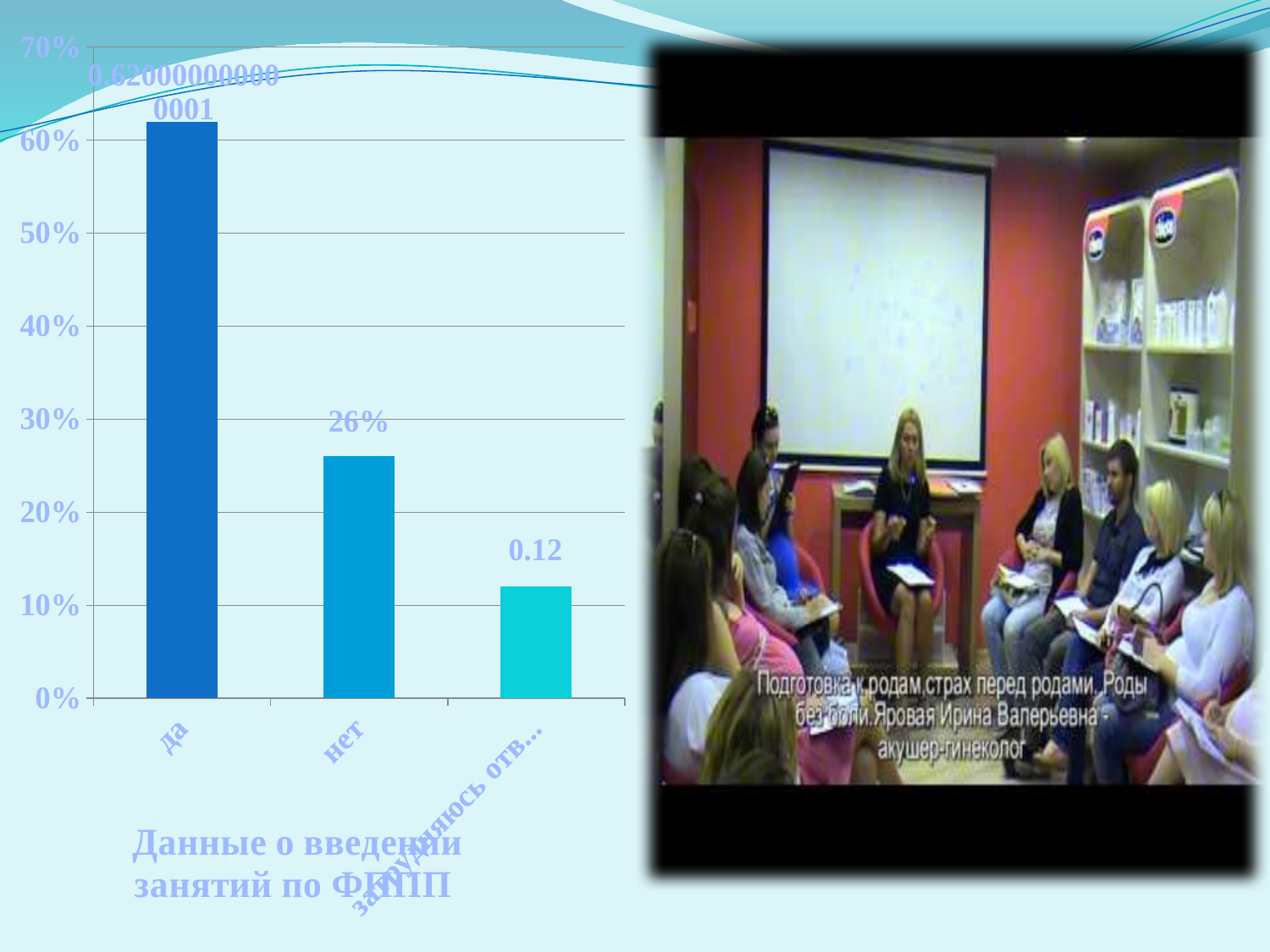
Is the value for "нет" greater or less than 30%? less Which category has the highest bar? да What is the title of the chart? Данные о введении занятий по ФППП Which category has the lowest bar? затрудняюсь отв... What is the data label printed above the bar for "да"? 0.620000000000001 What is the data label shown on the bar for "нет"? 26% Which bar is taller, "да" or "нет"? да Is the value for "да" greater or less than 60%? greater How many categories are plotted in the bar chart? 3 What type of chart is shown on the slide? bar chart What is the data label shown on the third bar ("затрудняюсь отв...")? 0.12 Do the bar values rise or fall from left to right along the x axis? fall